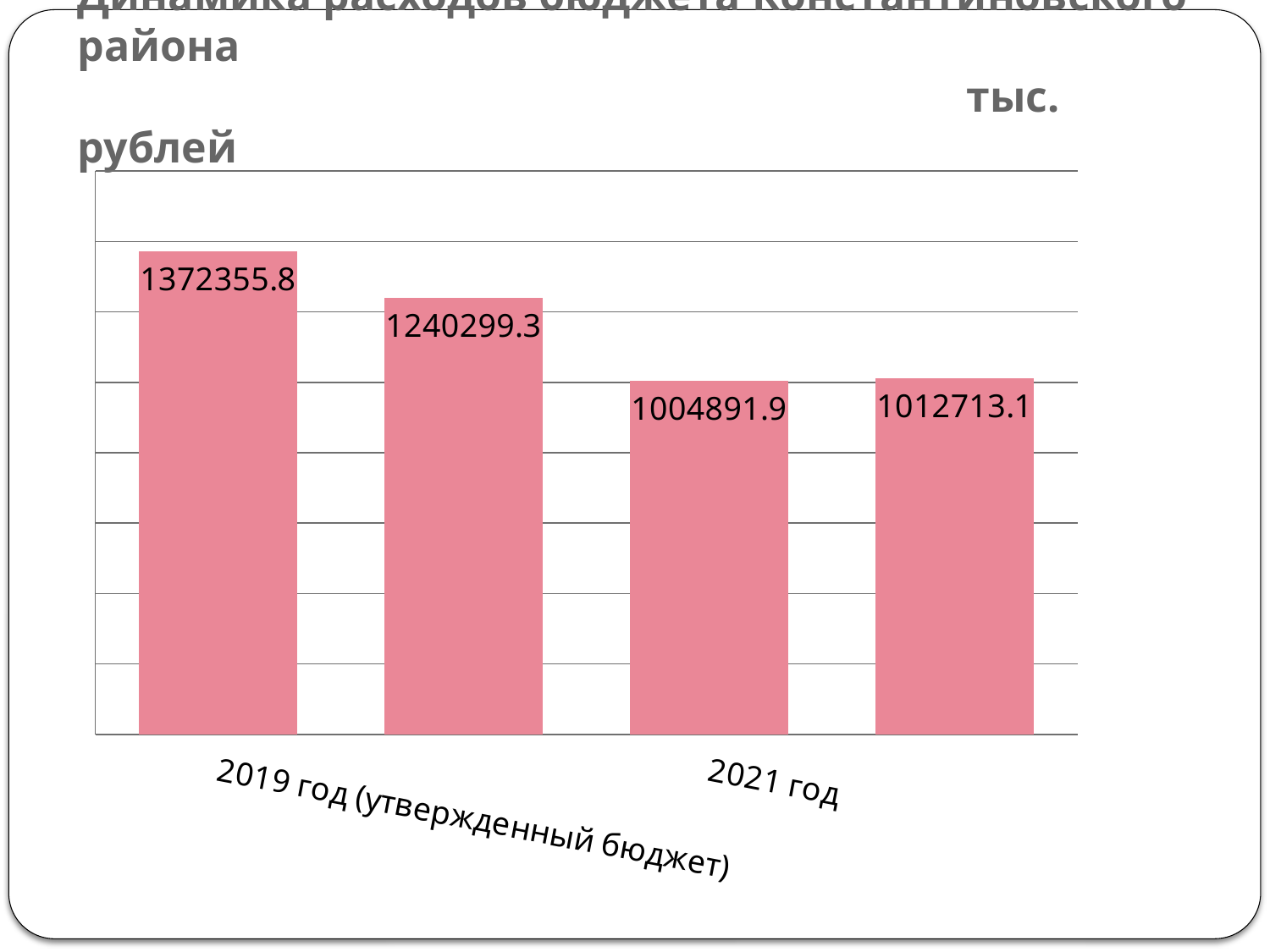
What is the difference between the values for 2019 год (утвержденный бюджет) and 2021 год? 367463.9 What is the difference between the first bar (1372355.8) and the second bar (1240299.3)? 132056.5 How many bars are shown in the chart? 4 What is the value for 2019 год (утвержденный бюджет)? 1372355.8 What is the value for 2021 год? 1004891.9 What kind of chart is shown on the slide? bar chart Which category has the highest value? 2019 год (утвержденный бюджет) What is the value shown on the rightmost bar? 1012713.1 Which is larger, the value for 2019 год (утвержденный бюджет) or the value for 2021 год? 2019 год (утвержденный бюджет) What is the value shown on the second bar from the left? 1240299.3 Which category has the lowest value? 2021 год Do the values rise or fall from 2019 год (утвержденный бюджет) to 2021 год? fall